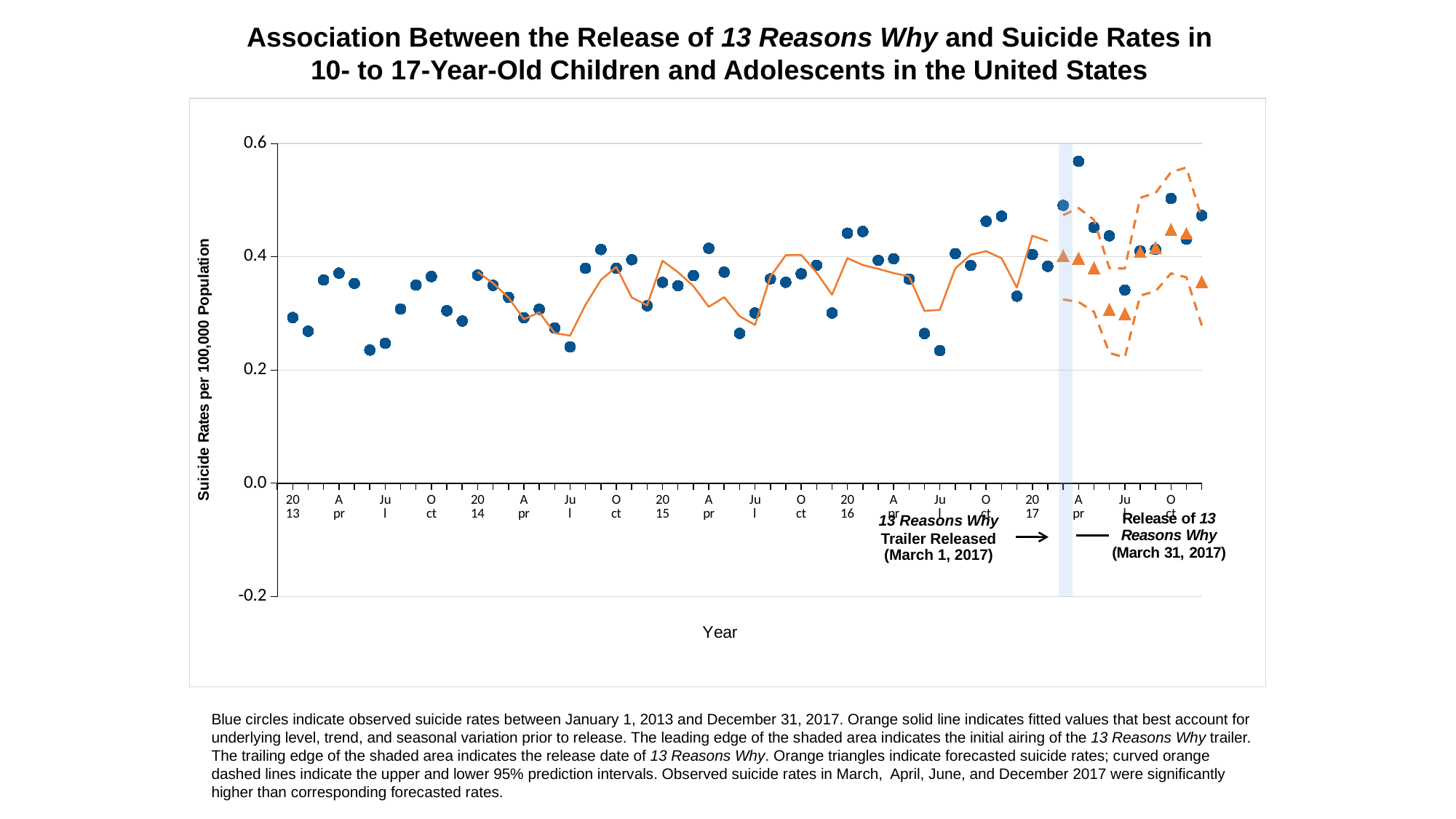
According to the caption, what do the orange triangles indicate? Forecasted suicide rates Is the highest observed suicide rate (blue circle, April 2017) greater or less than 0.6? less In April 2017, which is larger: the observed rate (blue circle) or the forecasted rate (orange triangle)? the observed rate (blue circle) Is the observed suicide rate (blue circle) for July 2016 greater or less than 0.4? less In which month is the highest observed suicide rate (blue circle) plotted? April 2017 Do the observed suicide rates generally rise or fall from 2013 to 2017? rise What is the title of the vertical axis? Suicide Rates per 100,000 Population How many year labels (2013 through 2017) appear on the x axis? 5 What kind of chart is shown on the slide? scatter chart Is the highest observed suicide rate (blue circle, April 2017) greater or less than 0.4? greater Which observed value is larger: January 2013 or April 2017? April 2017